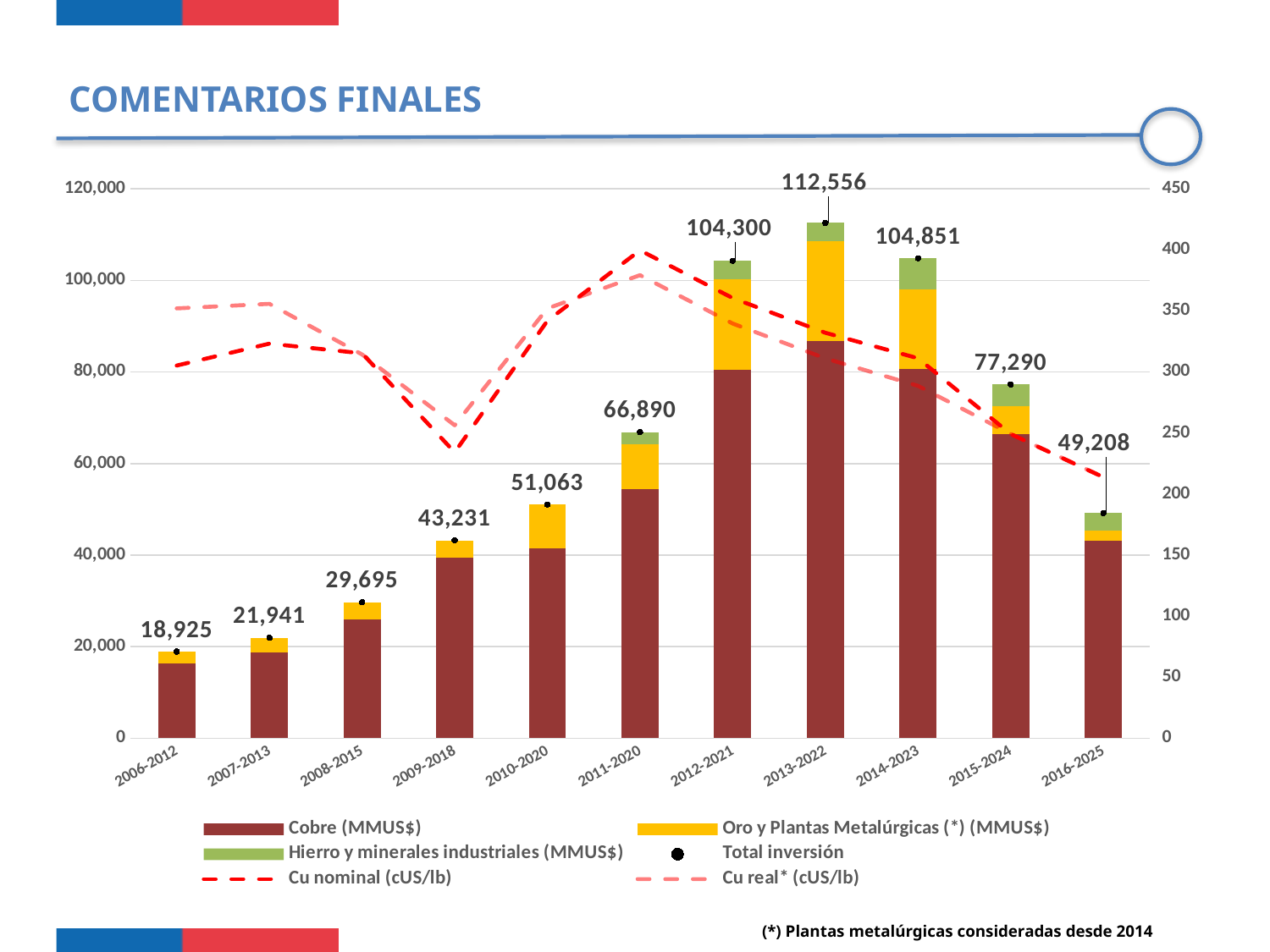
Does the total investment rise or fall from the 2013-2022 period to the 2016-2025 period? fall Which period has the highest total investment? 2013-2022 What is the total investment (Total inversión) shown for the 2013-2022 period? 112,556 How many entries does the legend list? 6 What is the total investment label for the 2006-2012 period? 18,925 What is the difference between the total investment for 2013-2022 and for 2014-2023? 7,705 What is the difference between the total investment for 2016-2025 and for 2006-2012? 30,283 What is the total investment label for the 2016-2025 period? 49,208 Is the Cobre (MMUS$) value for the 2013-2022 period greater or less than 80,000? greater How many periods (categories) are shown on the x axis? 11 Which period has a larger total investment, 2012-2021 or 2014-2023? 2014-2023 Which period has the lowest total investment? 2006-2012